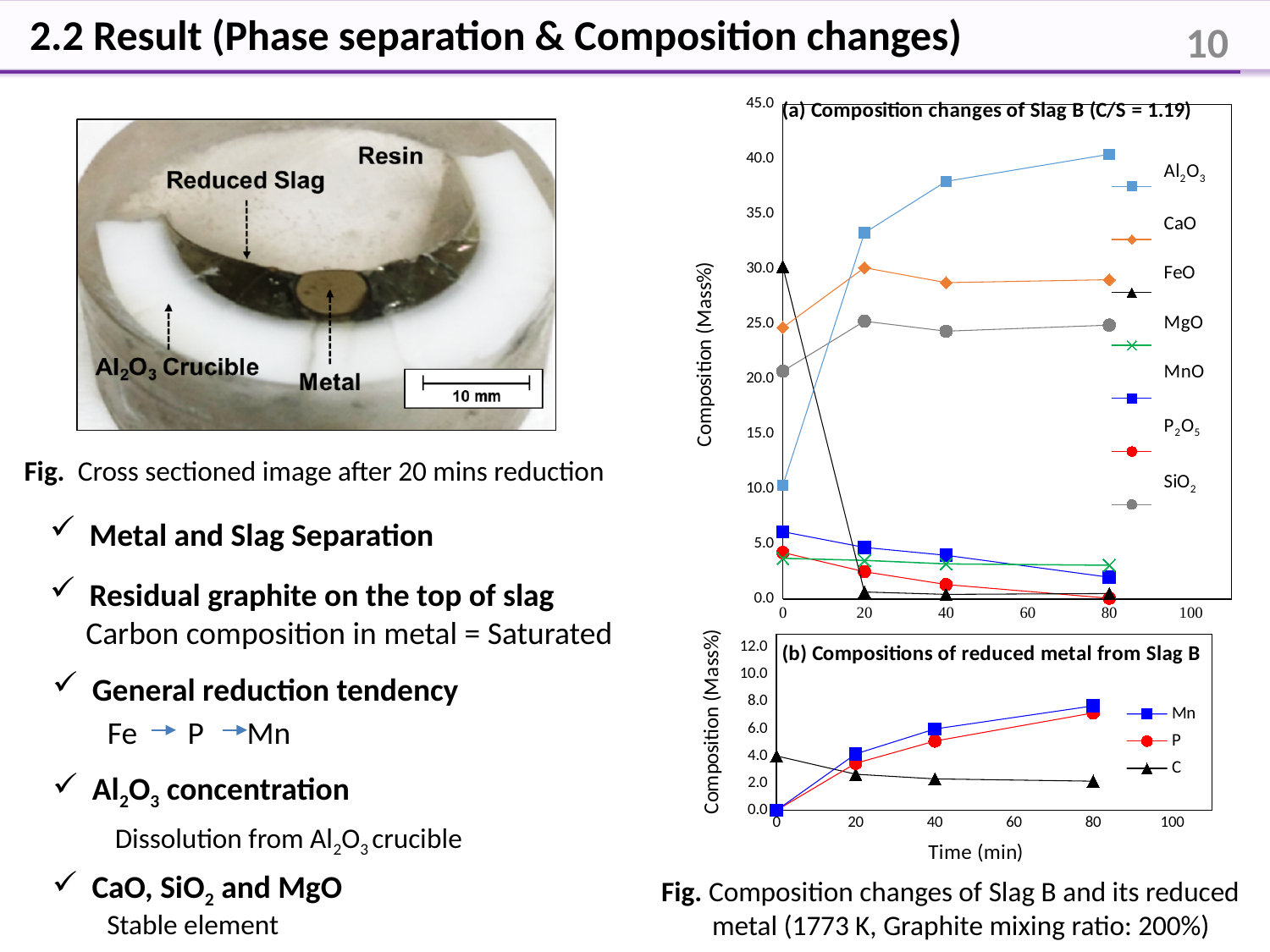
In chart (a) Composition changes of Slag B, does the FeO value rise or fall as time increases? fall What kind of chart is chart (a) Composition changes of Slag B? line chart In chart (b) Compositions of reduced metal from Slag B, how many series does the legend list? 3 In chart (a) Composition changes of Slag B, is the value for Al2O3 at 80 min greater or less than 35? greater In chart (b) Compositions of reduced metal from Slag B, is the value for Mn at 80 min greater or less than 6.0? greater In chart (a) Composition changes of Slag B, does the Al2O3 value rise or fall as time increases? rise In chart (b) Compositions of reduced metal from Slag B, does the C value rise or fall as time increases? fall In chart (a) Composition changes of Slag B, is the value for FeO at 20 min greater or less than 5? less In chart (a) Composition changes of Slag B, which series has the highest value at 80 min? Al2O3 In chart (a) Composition changes of Slag B, which is larger at 20 min, CaO or SiO2? CaO In chart (a) Composition changes of Slag B, how many series does the legend list? 7 In chart (a) Composition changes of Slag B, how many time points are plotted for each series? 4